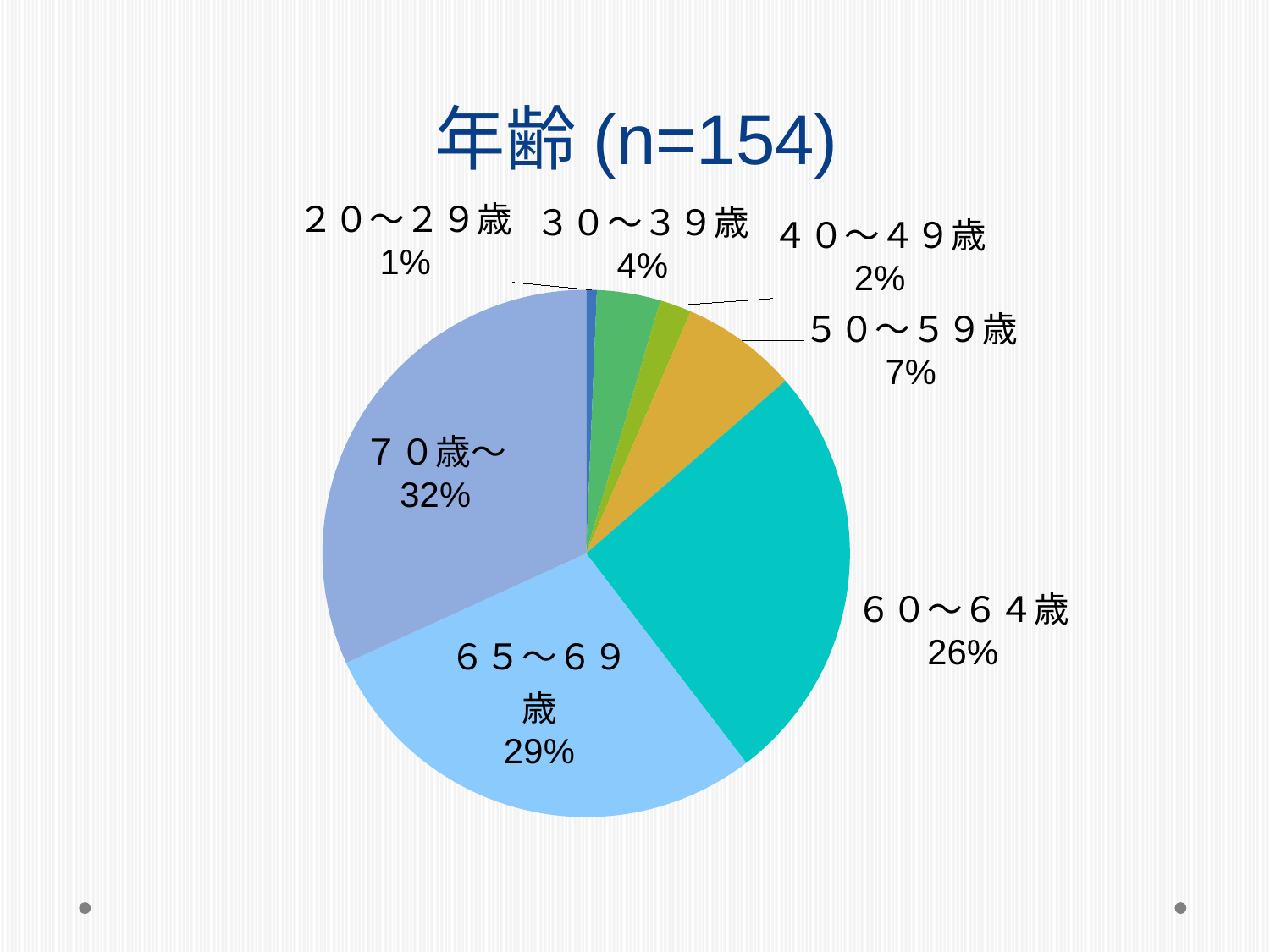
What share of the pie is the ７０歳～ slice? 32% What share of the pie is the ６５～６９歳 slice? 29% Which is larger, the share for ５０～５９歳 or the share for ４０～４９歳? ５０～５９歳 What is the difference in percentage points between the ７０歳～ slice and the ６０～６４歳 slice? 6% Which age group has the smallest share of the pie? ２０～２９歳 What share of the pie is the ３０～３９歳 slice? 4% What kind of chart is shown on the slide? pie chart Which age group has the largest share of the pie? ７０歳～ How many slices does the pie chart have? 7 What is the title of the chart? 年齢 (n=154)